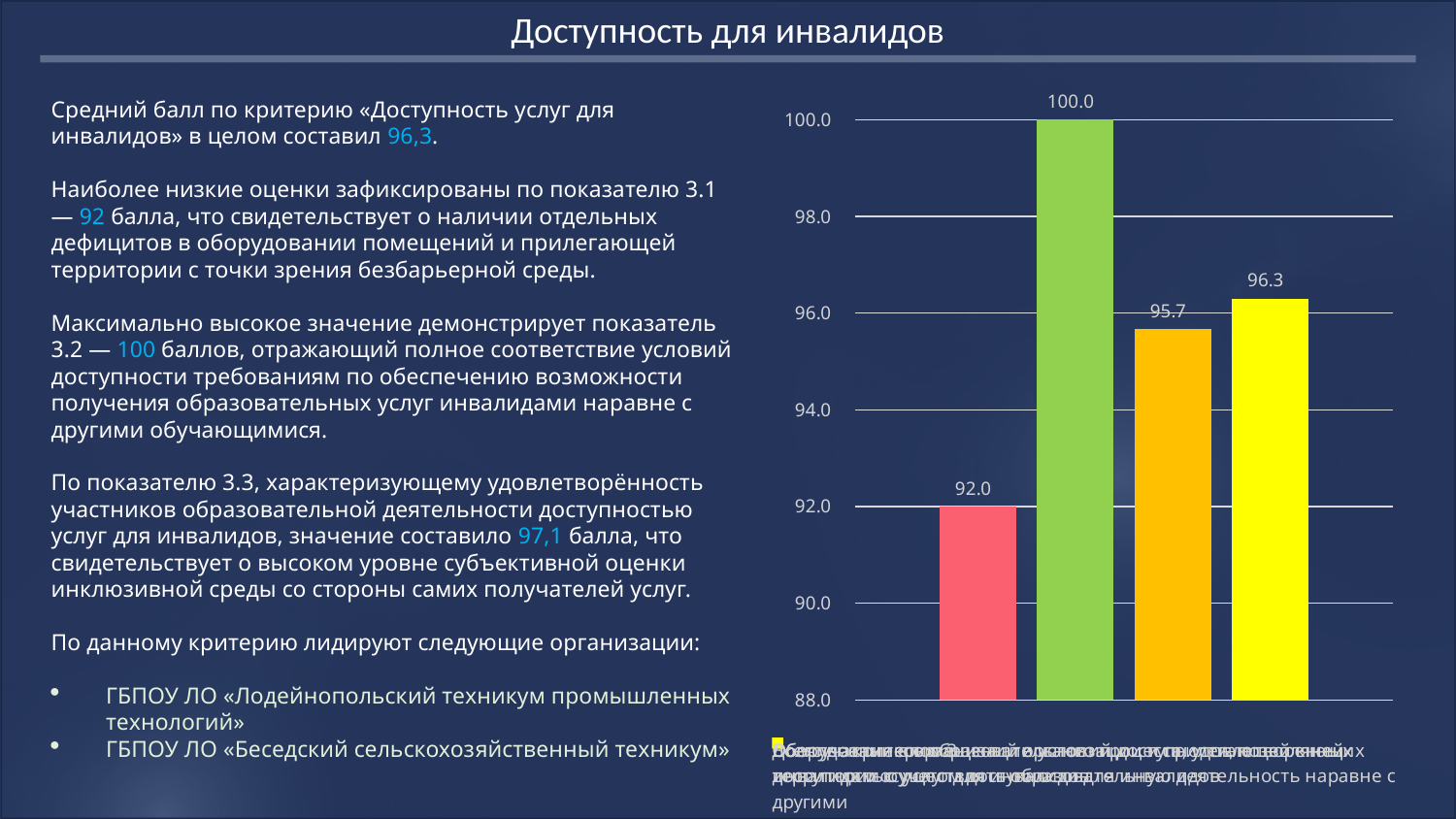
What is the difference between the yellow bar's value and the orange bar's value? 0.6 Is the value of the orange bar greater or less than 96.0? less What kind of chart is shown on the slide? bar chart Is the value of the red bar greater or less than 94.0? less What value is labelled on the yellow (fourth) bar? 96.3 What is the difference between the green bar's value and the red bar's value? 8.0 What value is labelled on the orange (third) bar? 95.7 What is the title of the slide containing the chart? Доступность для инвалидов What is the value shown on the shortest (red) bar? 92.0 How many bars are plotted in the chart? 4 Which bar is taller, the yellow bar or the orange bar? the yellow bar What is the value shown on the tallest (green) bar? 100.0